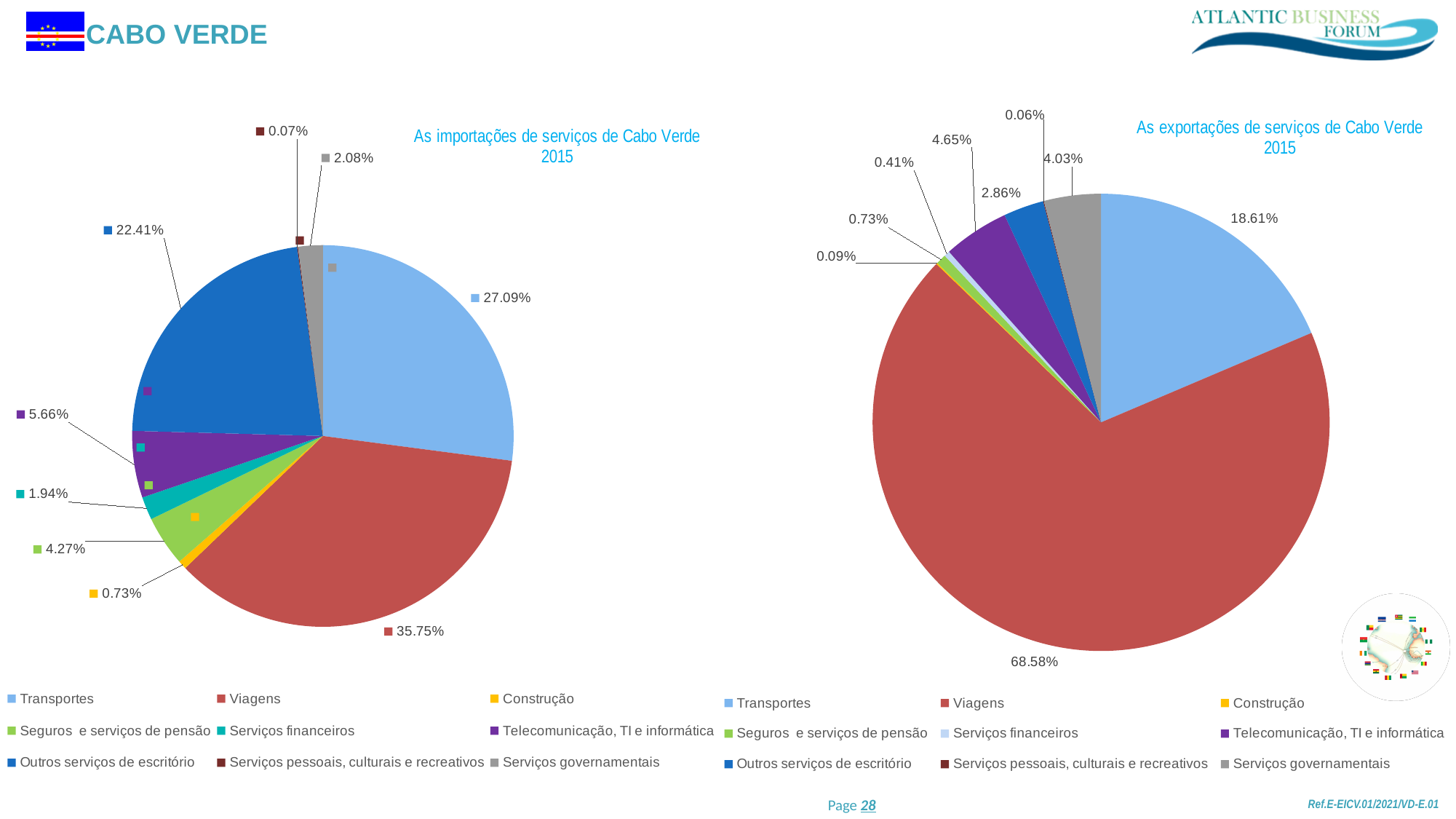
In the chart 'As exportações de serviços de Cabo Verde 2015', what share does Serviços governamentais have? 4.03% In the chart 'As importações de serviços de Cabo Verde 2015', what share does Transportes have? 27.09% In the chart 'As importações de serviços de Cabo Verde 2015', which category has the smallest share? Serviços pessoais, culturais e recreativos In the chart 'As exportações de serviços de Cabo Verde 2015', what share does Viagens have? 68.58% In the chart 'As exportações de serviços de Cabo Verde 2015', what share does Transportes have? 18.61% In the chart 'As importações de serviços de Cabo Verde 2015', what share does Viagens have? 35.75% In the chart 'As importações de serviços de Cabo Verde 2015', what is the difference between the shares of Viagens and Transportes? 8.66% What type of chart is 'As importações de serviços de Cabo Verde 2015'? Pie chart In the chart 'As exportações de serviços de Cabo Verde 2015', which category has the largest share? Viagens In the chart 'As exportações de serviços de Cabo Verde 2015', which is larger: Telecomunicação, TI e informática or Outros serviços de escritório? Telecomunicação, TI e informática How many categories does the legend of the chart 'As exportações de serviços de Cabo Verde 2015' list? 9 In the chart 'As importações de serviços de Cabo Verde 2015', what share does Outros serviços de escritório have? 22.41%